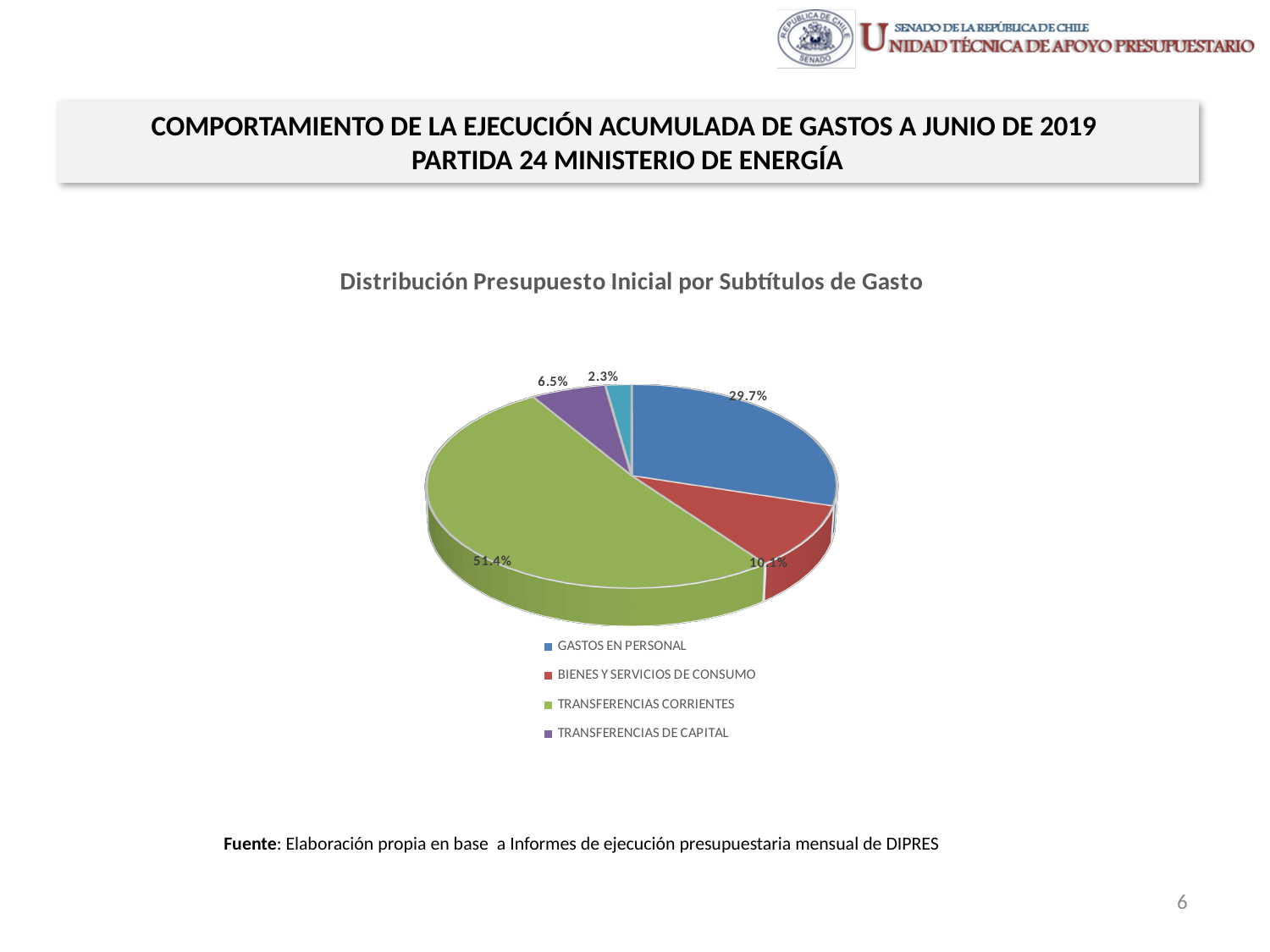
What kind of chart is shown on the slide? pie chart What is the title of the chart? Distribución Presupuesto Inicial por Subtítulos de Gasto What percentage of the pie does GASTOS EN PERSONAL represent? 29.7% How many percentage points larger is the share of TRANSFERENCIAS CORRIENTES than that of GASTOS EN PERSONAL? 21.7 percentage points How many entries does the chart legend list? 4 Which category has the largest share of the pie? TRANSFERENCIAS CORRIENTES How many slices does the pie chart have? 5 What is the percentage shown on the smallest slice of the pie? 2.3% What percentage of the pie does TRANSFERENCIAS CORRIENTES represent? 51.4% Which has a larger share: GASTOS EN PERSONAL or BIENES Y SERVICIOS DE CONSUMO? GASTOS EN PERSONAL What percentage of the pie does TRANSFERENCIAS DE CAPITAL represent? 6.5% What percentage of the pie does BIENES Y SERVICIOS DE CONSUMO represent? 10.1%